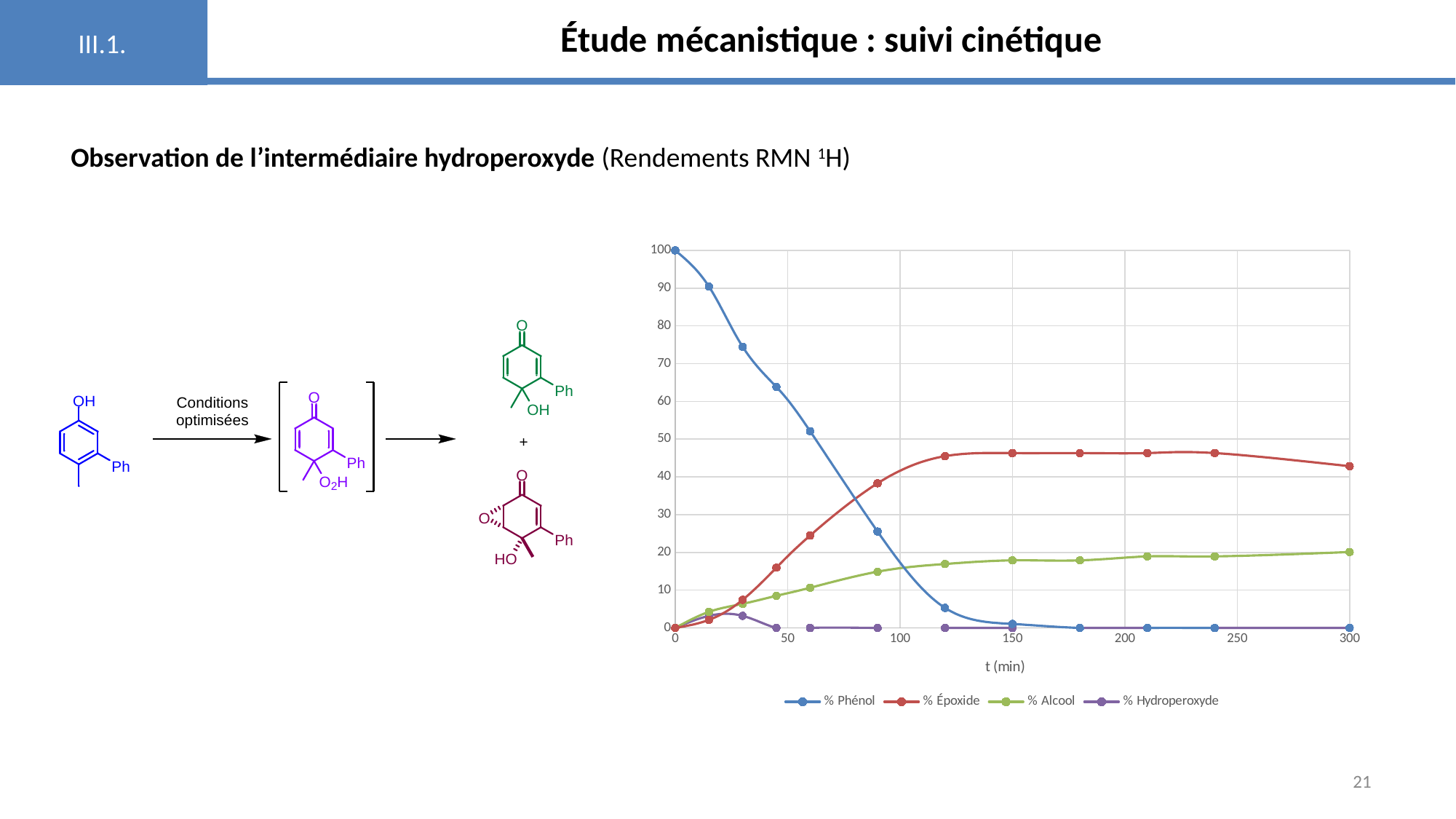
Is the value of % Phénol at 90 min greater or less than 30? less Is the value of % Époxide at 300 min greater or less than 40? greater Does the % Époxide series rise or fall over the first 120 minutes? rise Is the value of % Alcool at 300 min greater or less than 30? less How many series does the chart legend list? 4 What kind of chart is shown on the slide? line chart Which series has the highest value at 300 min? % Époxide Does the % Phénol series rise or fall as t increases? fall What is the value of % Phénol at t = 0 min? 100 What is the title of the x axis of the chart? t (min) At 300 min, which is larger: % Époxide or % Alcool? % Époxide